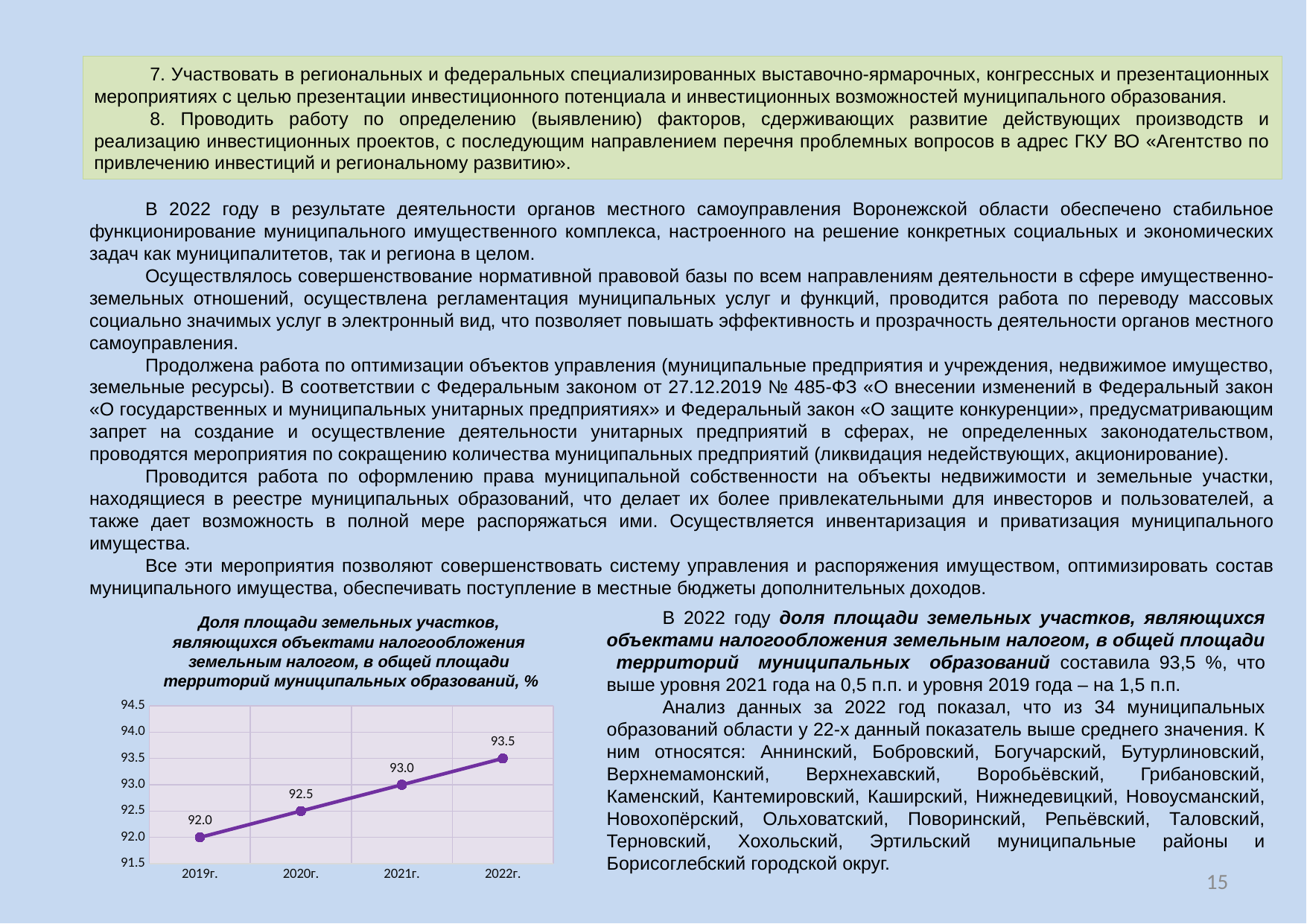
What is the value for 2022г. in the chart? 93.5 What is the value for 2021г. in the chart? 93.0 What kind of chart is shown on the slide? line chart Which year has the highest value in the chart? 2022г. What is the difference between the values for 2021г. and 2020г.? 0.5 Do the values rise or fall from 2019г. to 2022г.? rise What is the value for 2020г. in the chart? 92.5 What is the difference between the values for 2022г. and 2019г.? 1.5 Which year has the lowest value in the chart? 2019г. What is the value for 2019г. in the chart? 92.0 Which is larger, the value for 2020г. or the value for 2021г.? 2021г. How many data points are plotted in the chart? 4